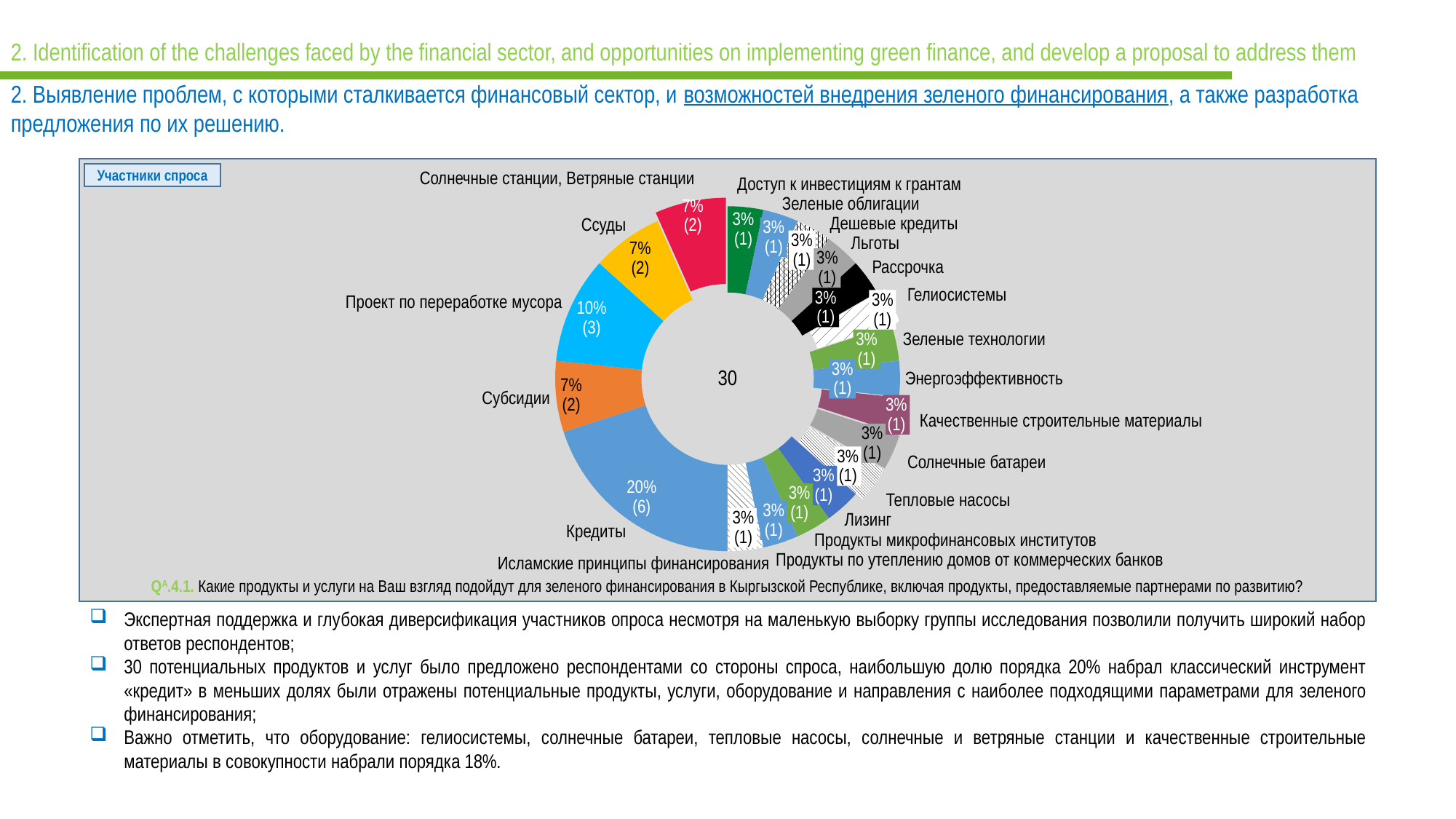
Which category has the largest share of the chart? Кредиты What percentage share is shown for Проект по переработке мусора? 10% What is the difference in percentage points between the share for Кредиты and the share for Проект по переработке мусора? 10% How many categories are shown in the chart? 20 How many responses (in parentheses) are shown for Кредиты? 6 What kind of chart is shown on the slide? Doughnut (pie) chart What number is shown in the centre of the doughnut chart? 30 How many responses are shown for Гелиосистемы? 1 What label appears in the box at the top-left corner of the chart area? Участники спроса What percentage share is shown for Кредиты? 20% Which is larger, the share for Ссуды or the share for Проект по переработке мусора? Проект по переработке мусора What percentage share is shown for Субсидии? 7%